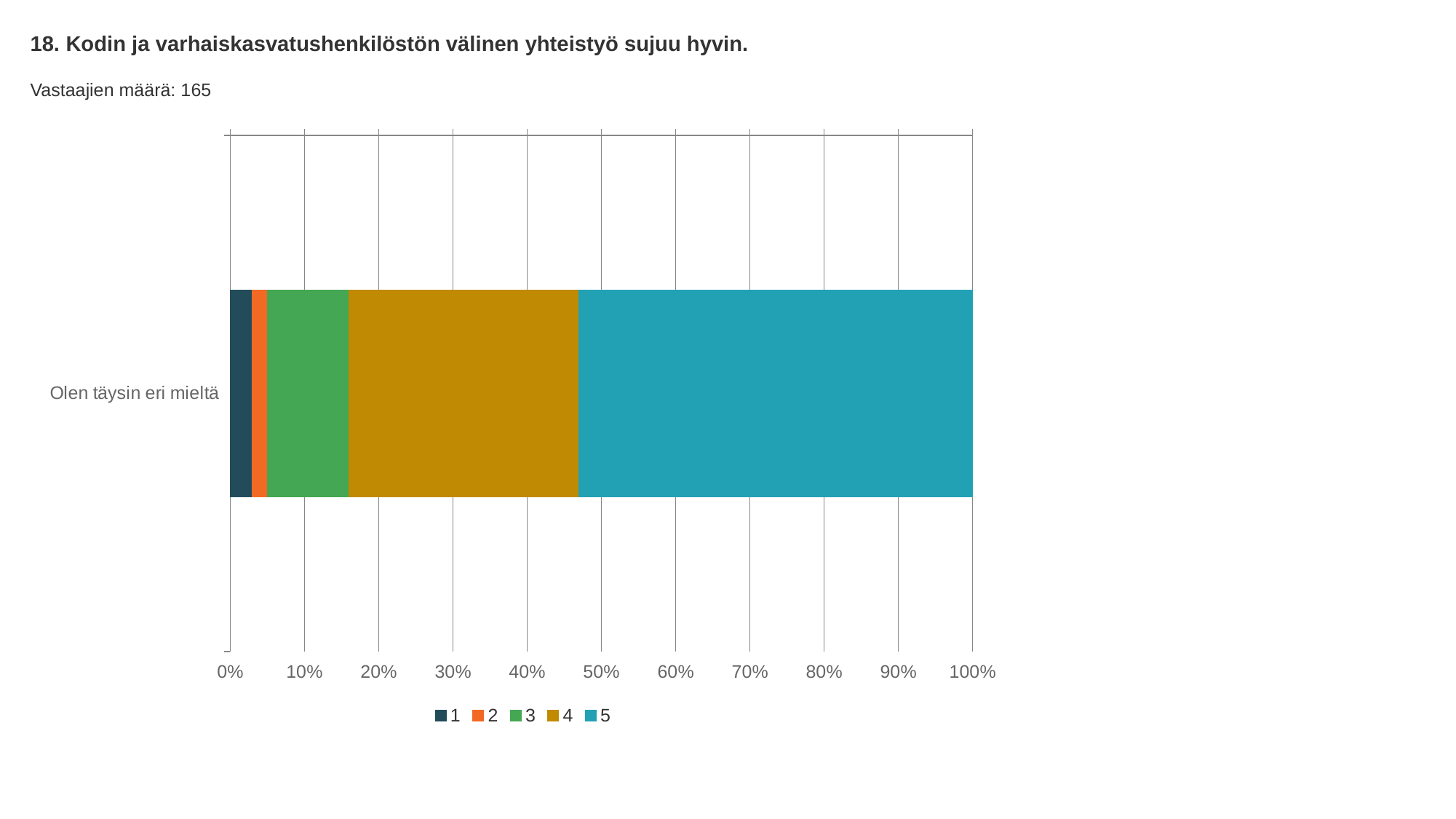
How many categories (bars) are plotted in the chart? 1 Is the share for series 5 greater or less than 50%? greater What is the category label shown on the y axis of the chart? Olen täysin eri mieltä Is the share for series 3 greater or less than 20%? less How many series does the legend list? 5 What kind of chart is shown on the slide? stacked bar chart Which is larger in the bar: the segment for series 3 or the segment for series 4? 4 Is the share for series 4 greater or less than 40%? less Which is larger in the bar: the segment for series 4 or the segment for series 5? 5 What is the number of respondents (Vastaajien määrä) stated on the slide? 165 Which series occupies the largest share of the bar? 5 What is the total of the stacked bar, as shown by where it ends on the x axis? 100%